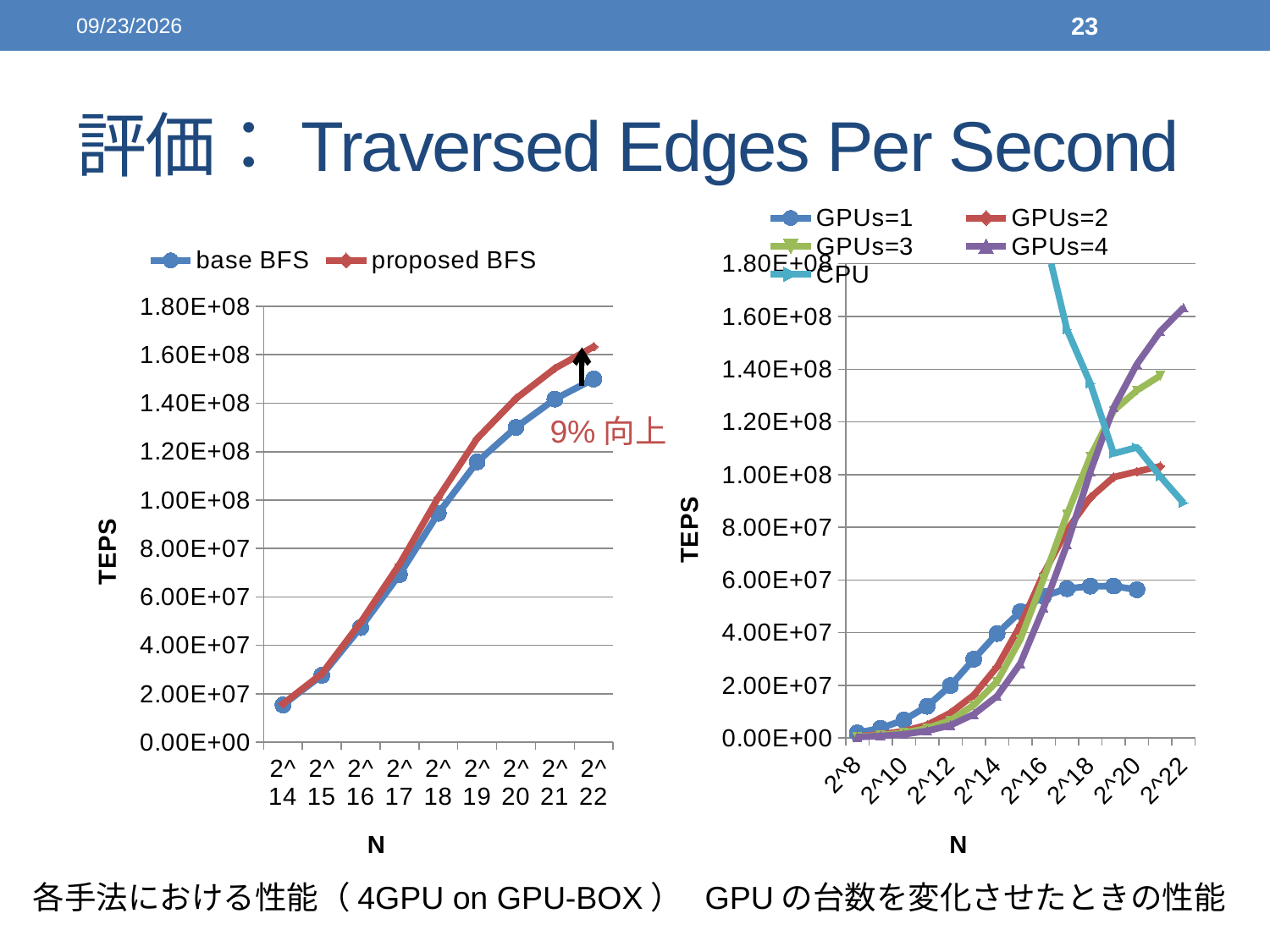
How many series does the legend of the right chart list? 5 How many series does the legend of the left chart list? 2 In the left chart, is the value for base BFS at N = 2^22 greater or less than 1.60E+08? less In the right chart, which series is higher at N = 2^22, GPUs=4 or CPU? GPUs=4 What type of chart is the left chart (base BFS vs proposed BFS)? line chart In the left chart, is the value for base BFS at N = 2^14 greater or less than 2.00E+07? less What is the y-axis label of the right chart? TEPS In the left chart, which series is higher at N = 2^22, base BFS or proposed BFS? proposed BFS In the left chart, do the TEPS values for proposed BFS rise or fall as N increases? rise In the right chart, is the value for GPUs=1 at N = 2^20 greater or less than 8.00E+07? less How many N values are plotted on the x axis of the left chart? 9